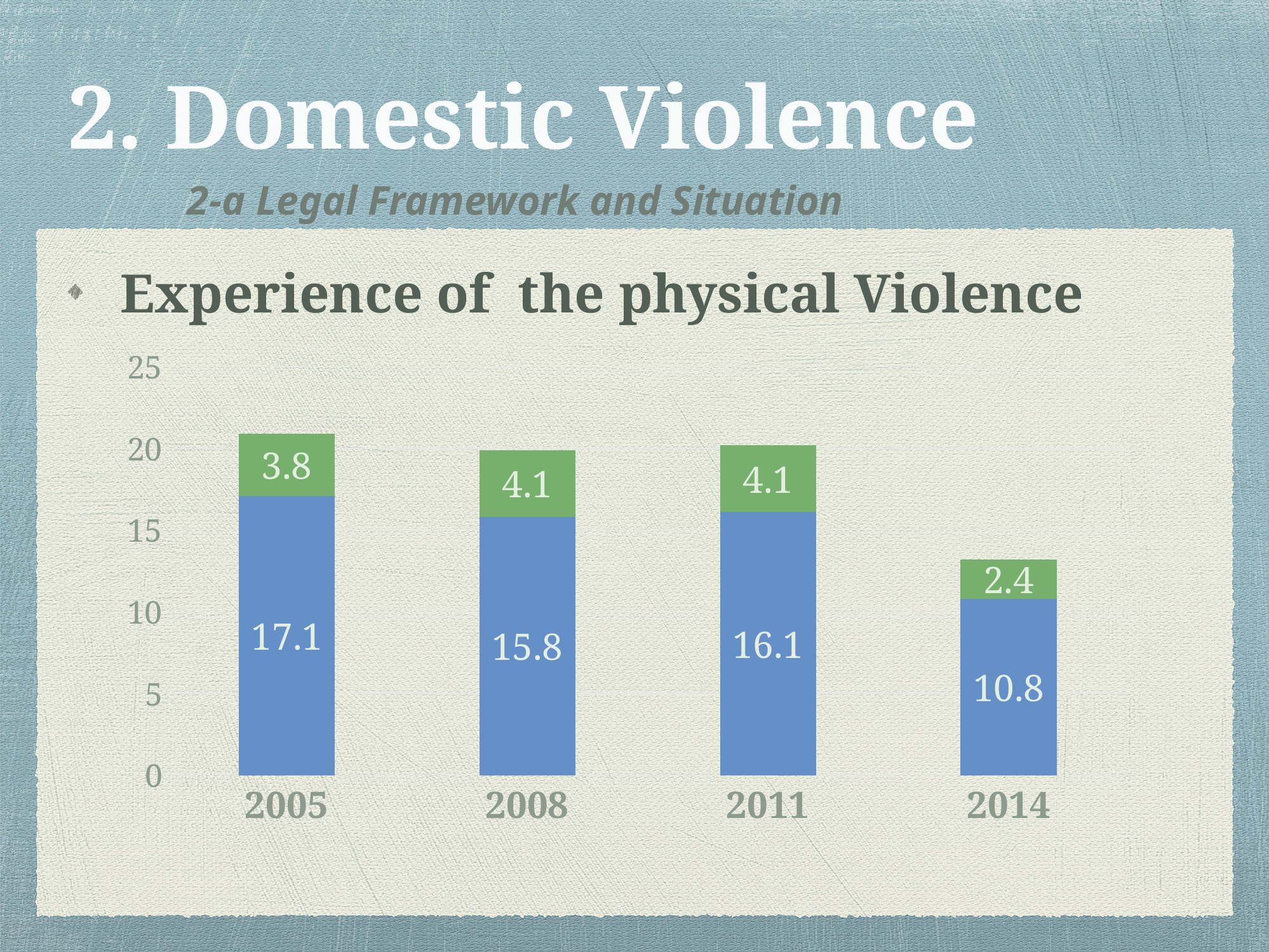
What is the value of the green segment for 2014? 2.4 What is the total of the stacked bar for 2005? 20.9 Which is larger, the blue segment for 2008 or the blue segment for 2011? 2011 What is the difference between the blue segment values for 2005 and 2014? 6.3 What is the value of the blue segment for 2005? 17.1 Which year has the lowest green segment value? 2014 What kind of chart is shown on the slide? Stacked bar chart How many years are shown on the x axis? 4 What is the value of the blue segment for 2011? 16.1 Which year has the highest blue segment value? 2005 What is the total of the stacked bar for 2014? 13.2 Is the total of the stacked bar for 2014 greater or less than 15? less